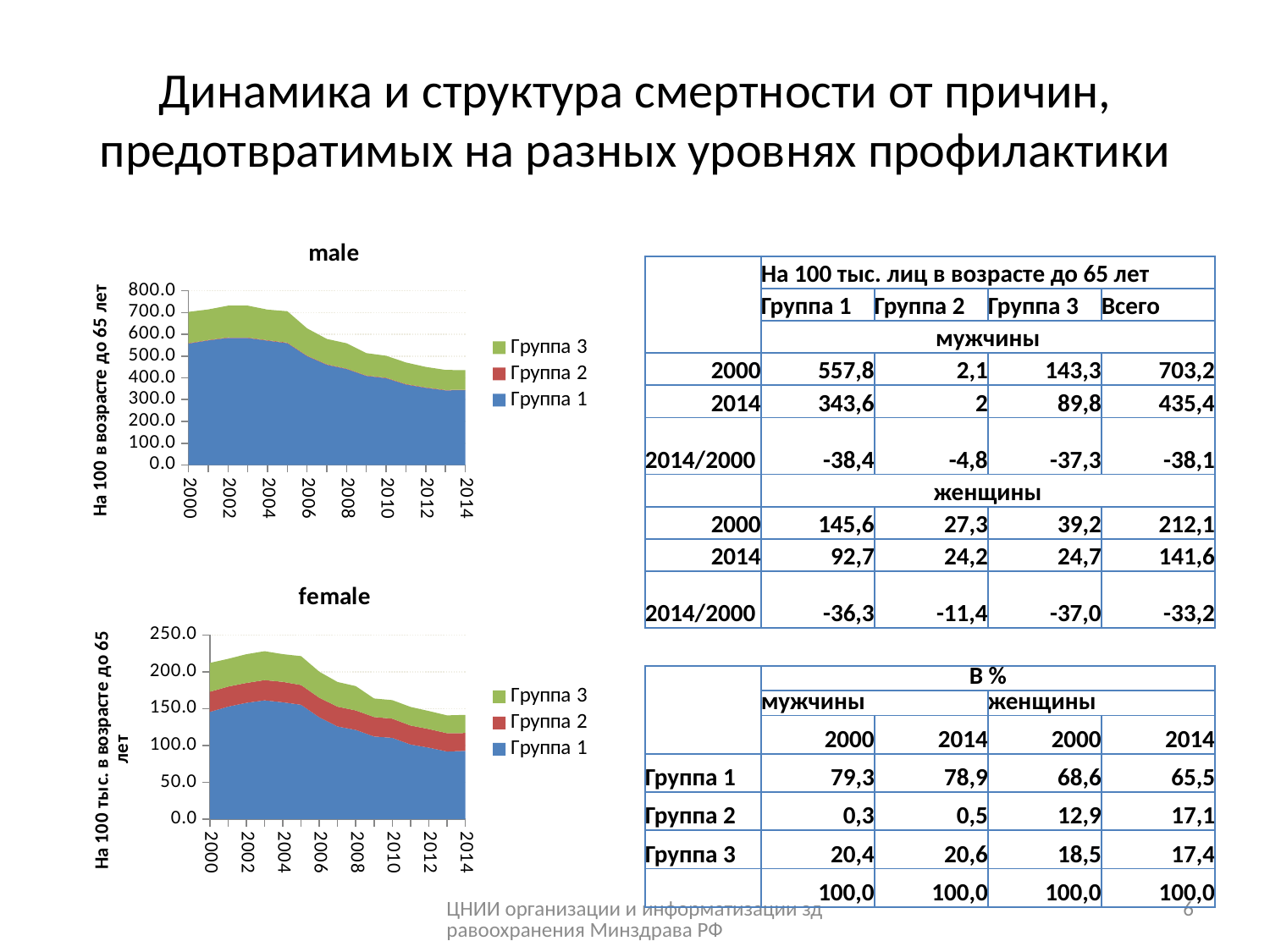
How many year labels are shown on the x axis of the "male" chart? 8 What kind of chart is the "male" chart? stacked area chart In the "male" chart, is the value for Группа 1 in 2014 greater or less than 400? less In the "female" chart, is the total stacked value in 2000 greater or less than 200? greater In the "female" chart, is the value for Группа 1 in 2000 greater or less than 100? greater In the "female" chart, does the Группа 1 area rise or fall from 2004 to 2014? fall In the "male" chart, does the total stacked value rise or fall from 2000 to 2014? fall In the "female" chart, which colour represents Группа 2? red How many series does the legend of the "female" chart list? 3